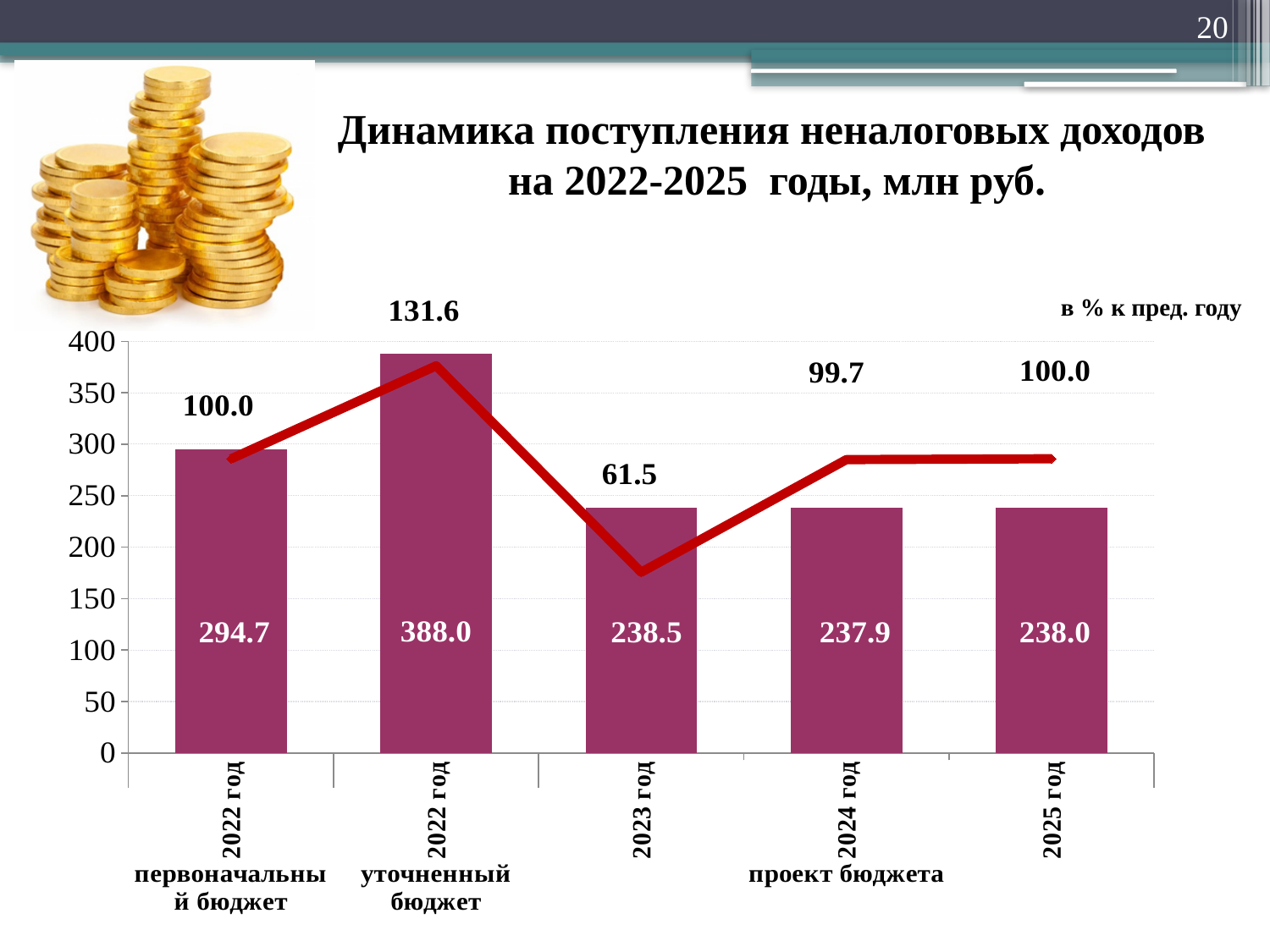
What is the value of the bar for 2022 год (уточненный бюджет)? 388.0 Which category has the highest bar? 2022 год (уточненный бюджет) What is the title of the chart? Динамика поступления неналоговых доходов на 2022-2025 годы, млн руб. What is the value of the bar for 2024 год? 237.9 How many bars are shown in the chart? 5 What is the line value (в % к пред. году) for 2022 год (уточненный бюджет)? 131.6 What is the difference between the bar values for 2022 год (уточненный бюджет) and 2022 год (первоначальный бюджет)? 93.3 What is the value of the bar for 2022 год (первоначальный бюджет)? 294.7 Which bar is larger: 2022 год (первоначальный бюджет) or 2023 год? 2022 год (первоначальный бюджет) What kind of chart is shown on the slide? A bar chart combined with a line Which category has the lowest line value (в % к пред. году)? 2023 год What is the line value (в % к пред. году) for 2023 год? 61.5